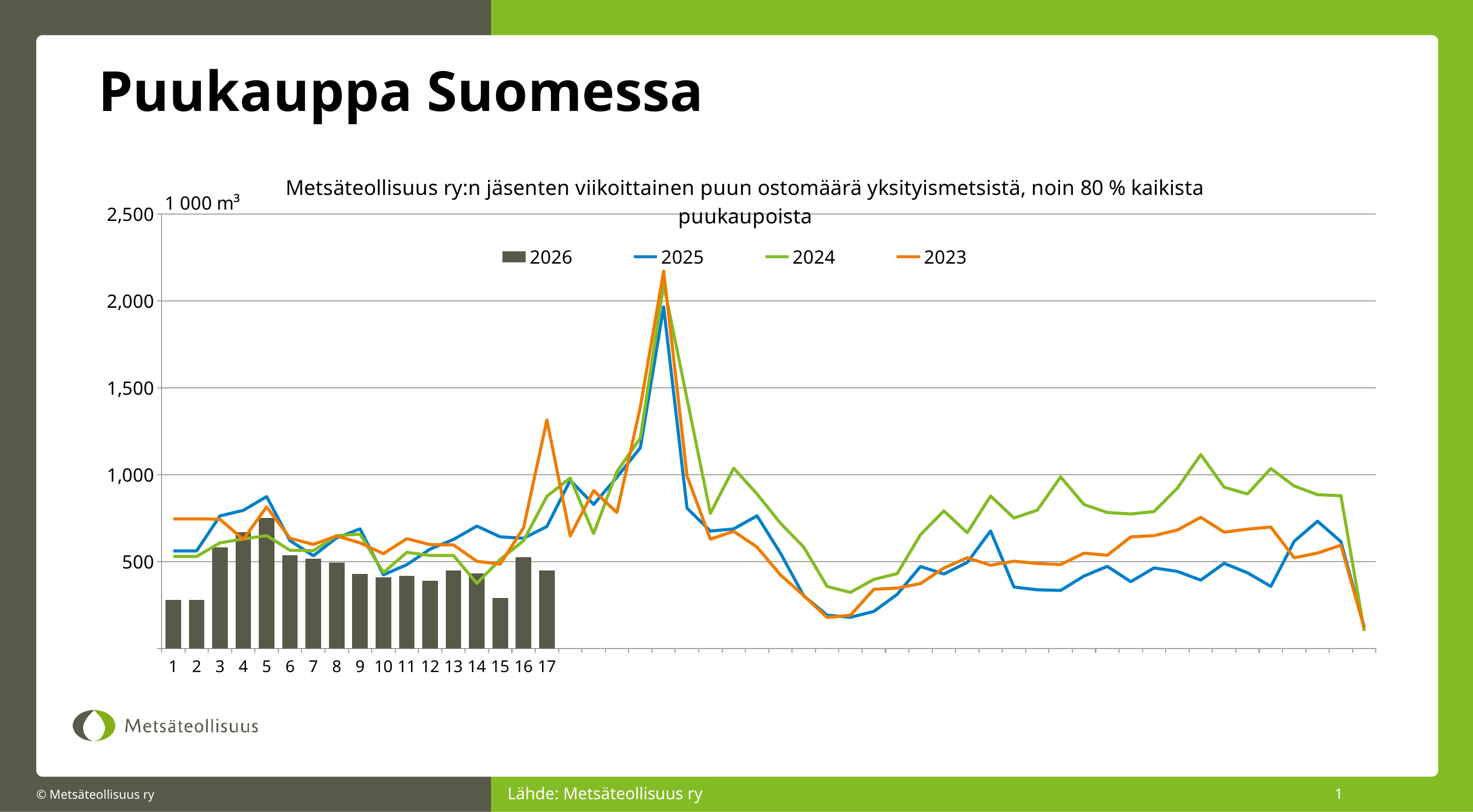
How many weeks have a bar for the 2026 series? 17 Is the 2026 value for week 5 greater or less than 500? greater Is the peak value of the 2023 line greater or less than 2,000? greater Which series is drawn as bars rather than a line? 2026 How many series does the legend list? 4 Do the 2026 bars rise or fall from week 5 to week 12? Fall What unit label is shown at the top of the vertical axis? 1 000 m³ In which week is the 2026 bar highest? 5 What kind of chart is shown on the slide? A combined bar and line chart Is the 2026 value for week 10 greater or less than 500? less Which is larger for 2026: the bar for week 5 or the bar for week 15? Week 5